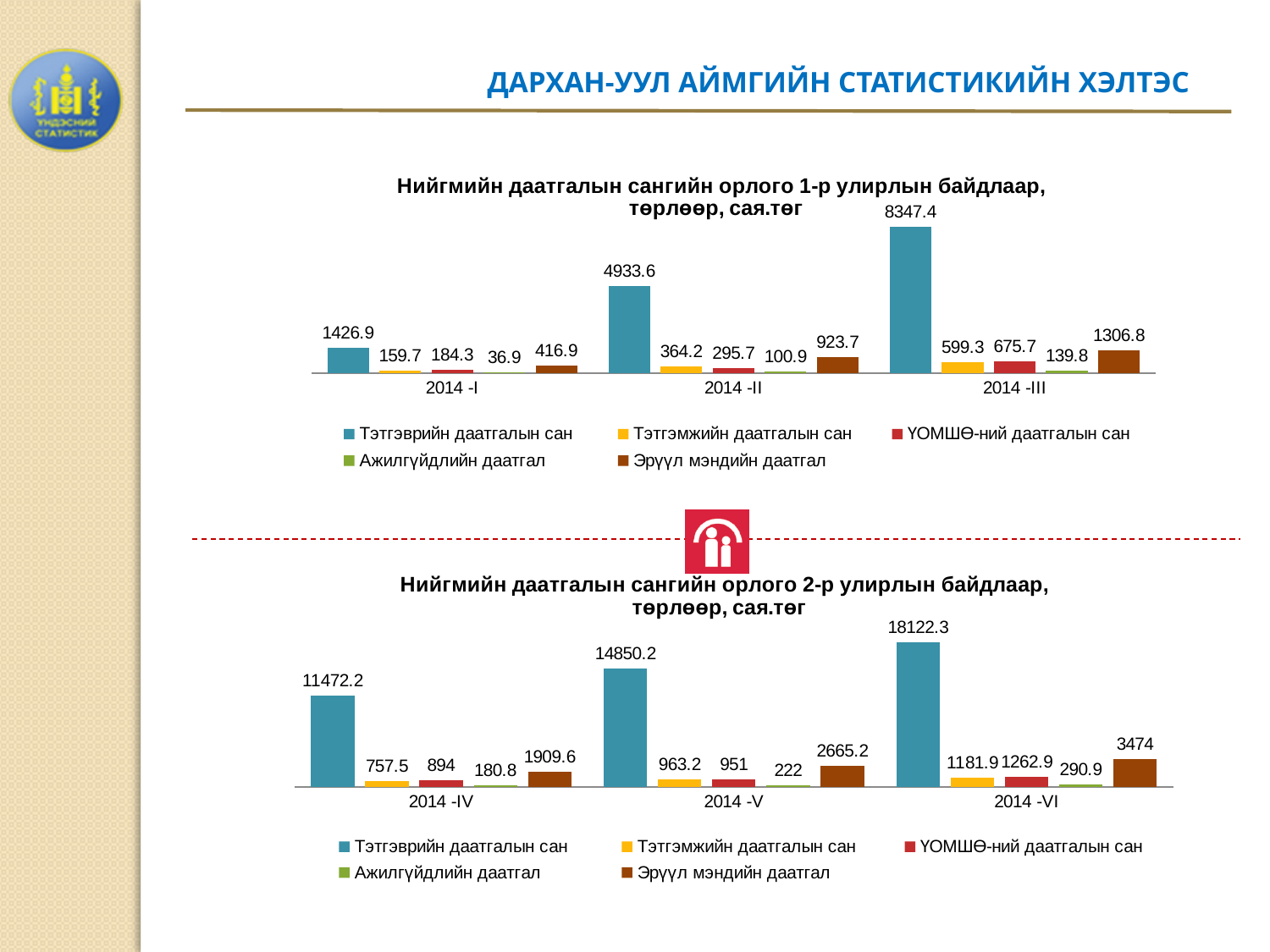
In the bottom chart (2-р улирлын байдлаар), what is the value of Тэтгэврийн даатгалын сан for 2014 -VI? 18122.3 In the top chart (1-р улирлын байдлаар), does Тэтгэврийн даатгалын сан rise or fall from 2014 -I to 2014 -III? rise In the bottom chart (2-р улирлын байдлаар), what is the difference between the Эрүүл мэндийн даатгал values for 2014 -V and 2014 -IV? 755.6 In the bottom chart (2-р улирлын байдлаар), what is the value of Эрүүл мэндийн даатгал for 2014 -VI? 3474 In the bottom chart (2-р улирлын байдлаар), which is larger for 2014 -V: Тэтгэмжийн даатгалын сан or ҮОМШӨ-ний даатгалын сан? Тэтгэмжийн даатгалын сан In the top chart (1-р улирлын байдлаар), which category has the lowest value for Ажилгүйдлийн даатгал? 2014 -I In the top chart (1-р улирлын байдлаар), what is the value of Эрүүл мэндийн даатгал for 2014 -II? 923.7 What type of chart is the bottom chart (2-р улирлын байдлаар)? bar chart In the bottom chart (2-р улирлын байдлаар), how many categories are shown on the x axis? 3 In the top chart (1-р улирлын байдлаар), how many series does the legend list? 5 In the top chart (1-р улирлын байдлаар), what is the value of Тэтгэврийн даатгалын сан for 2014 -III? 8347.4 In the top chart (1-р улирлын байдлаар), what is the difference between the Тэтгэврийн даатгалын сан values for 2014 -III and 2014 -II? 3413.8